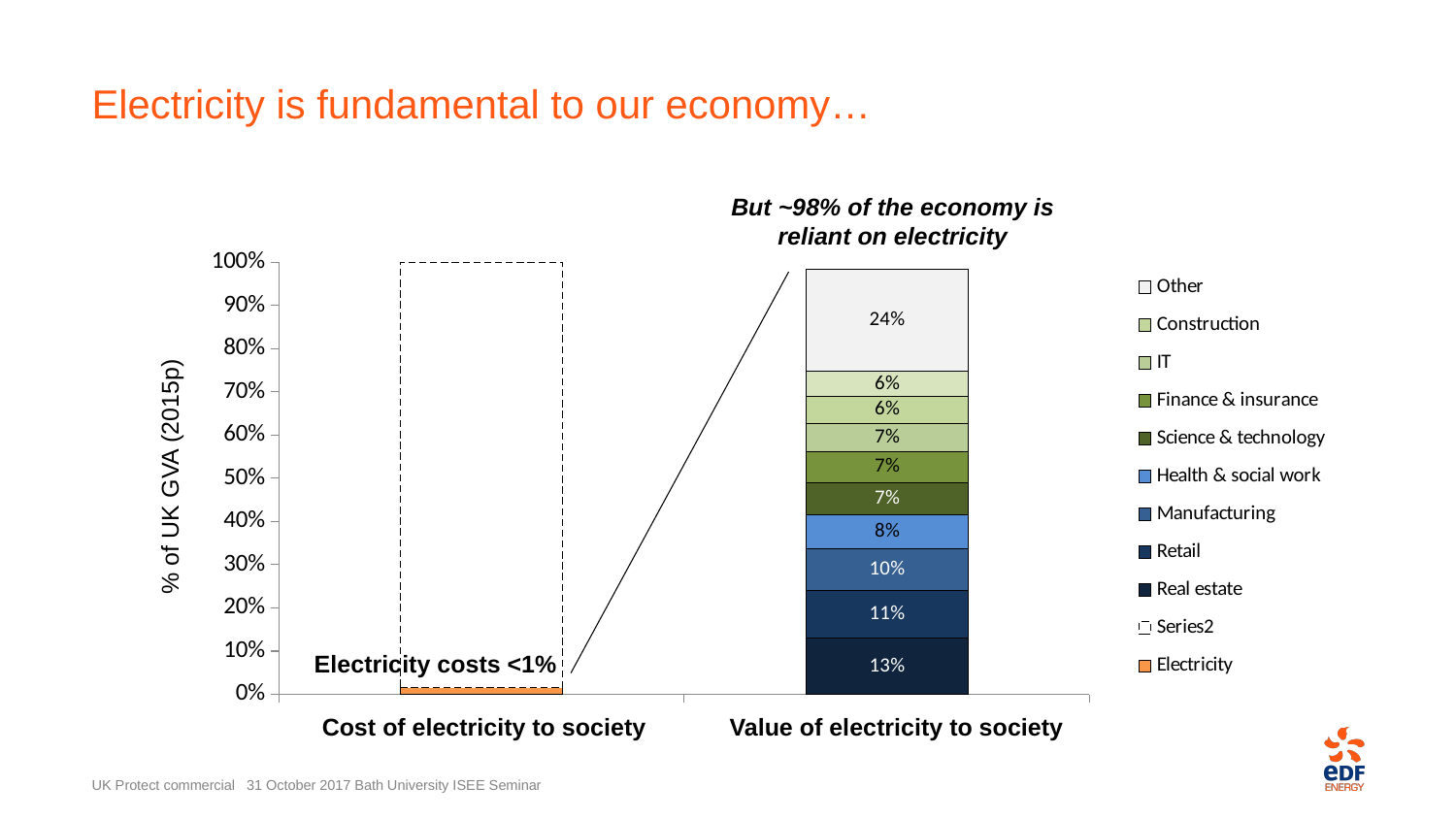
How many categories are shown on the x axis of the chart? 2 What is the difference between the Other segment (24%) and the Real estate segment (13%) in the 'Value of electricity to society' bar? 11 percentage points What is the value of the Retail segment in the 'Value of electricity to society' bar? 11% What is the value of the Other segment in the 'Value of electricity to society' bar? 24% What is the value of the Real estate segment in the 'Value of electricity to society' bar? 13% What is the value of the Manufacturing segment in the 'Value of electricity to society' bar? 10% How many entries does the chart's legend list? 11 Is the value of the 'Cost of electricity to society' bar greater or less than 10%? less What kind of chart is shown on the slide? Stacked bar chart What is the value of the Health & social work segment in the 'Value of electricity to society' bar? 8% Which is larger in the 'Value of electricity to society' bar, the Real estate segment or the Retail segment? Real estate Which segment is the largest in the 'Value of electricity to society' bar? Other